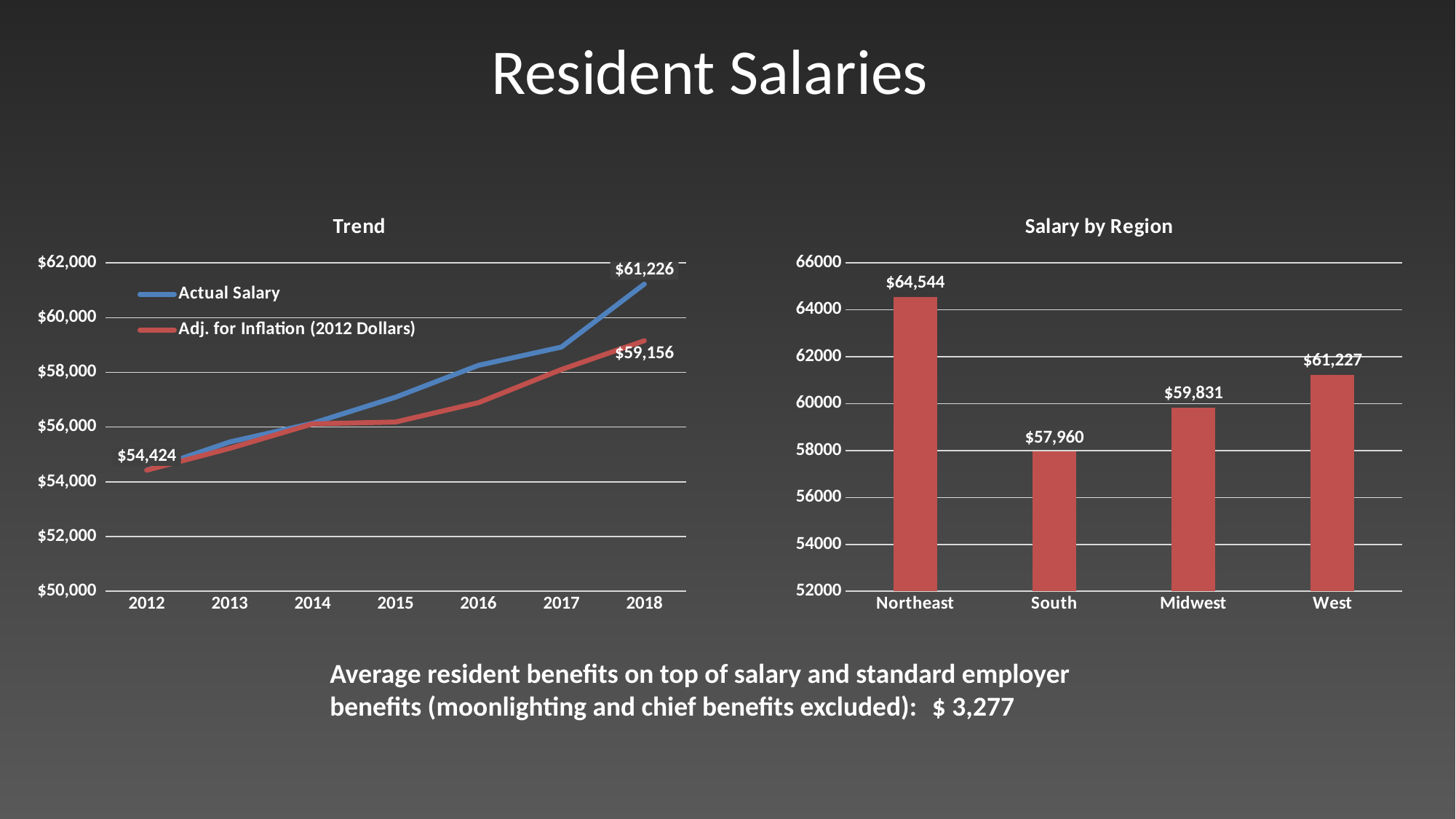
In the Trend chart, what is the Adj. for Inflation (2012 Dollars) value for 2018? $59,156 In the Salary by Region chart, what is the difference between the Northeast and South salaries? $6,584 In the Trend chart, what is the difference between the Actual Salary and the Adj. for Inflation value in 2018? $2,070 What kind of chart is the Salary by Region chart? Bar chart How many series does the legend of the Trend chart list? 2 In the Salary by Region chart, what is the salary for the Northeast? $64,544 How many regions are shown in the Salary by Region chart? 4 In the Trend chart, what is the Actual Salary value for 2018? $61,226 In the Salary by Region chart, which region has the highest salary? Northeast In the Trend chart, does the Actual Salary rise or fall from 2012 to 2018? Rise In the Salary by Region chart, is the salary for the Midwest or the West larger? West In the Salary by Region chart, which region has the lowest salary? South